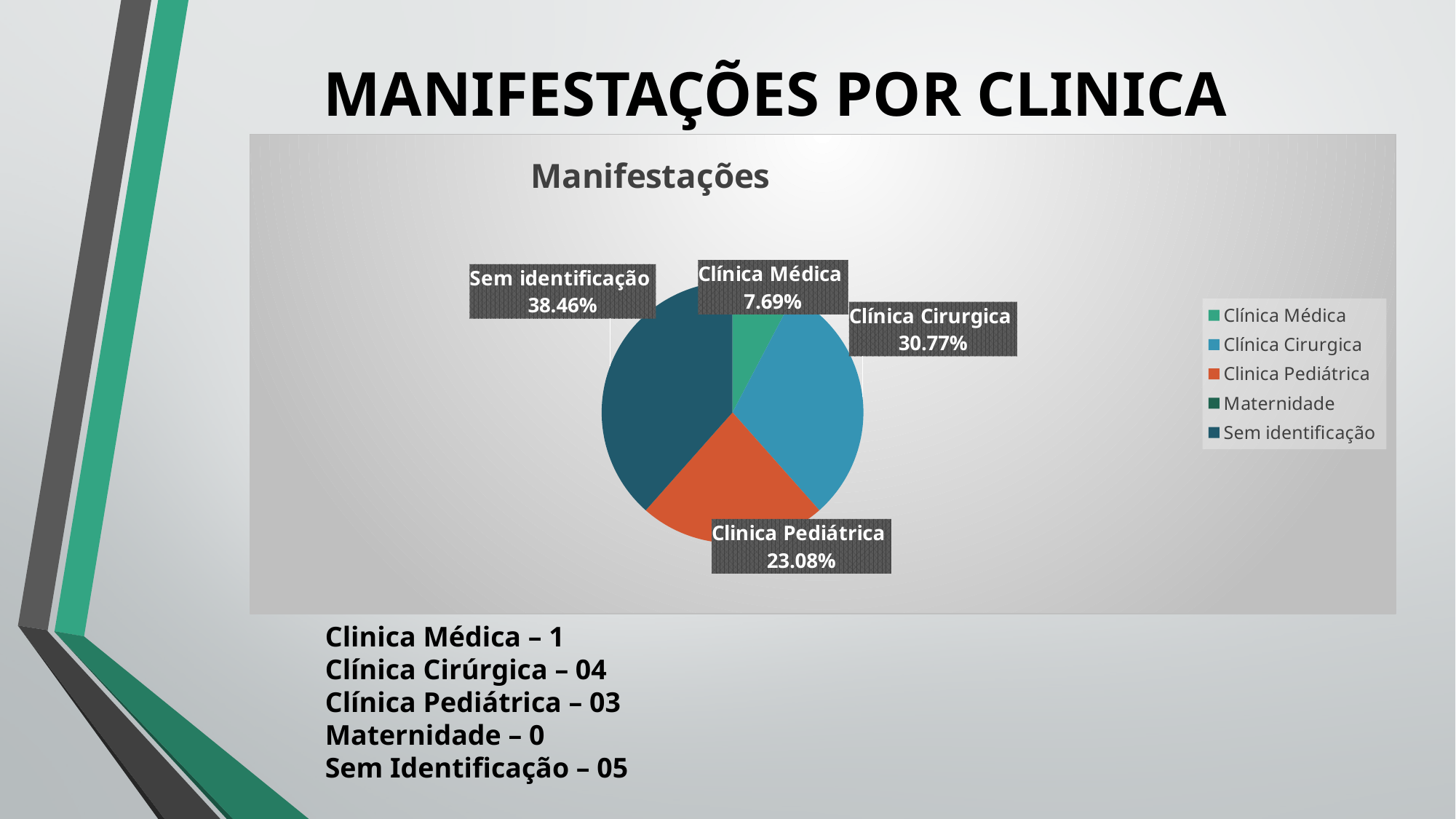
What share of the pie does Clínica Cirurgica have? 30.77% What share of the pie does Sem identificação have? 38.46% Which slice is larger, Clínica Cirurgica or Clinica Pediátrica? Clínica Cirurgica Which legend entry has no visible slice in the pie? Maternidade What is the chart's title? Manifestações How many entries does the legend list? 5 What is the difference in percentage points between Sem identificação and Clínica Cirurgica? 7.69 What share of the pie does Clínica Médica have? 7.69% Which category has the largest slice of the pie? Sem identificação What type of chart is shown on the slide? pie chart Which labelled slice of the pie is the smallest? Clínica Médica